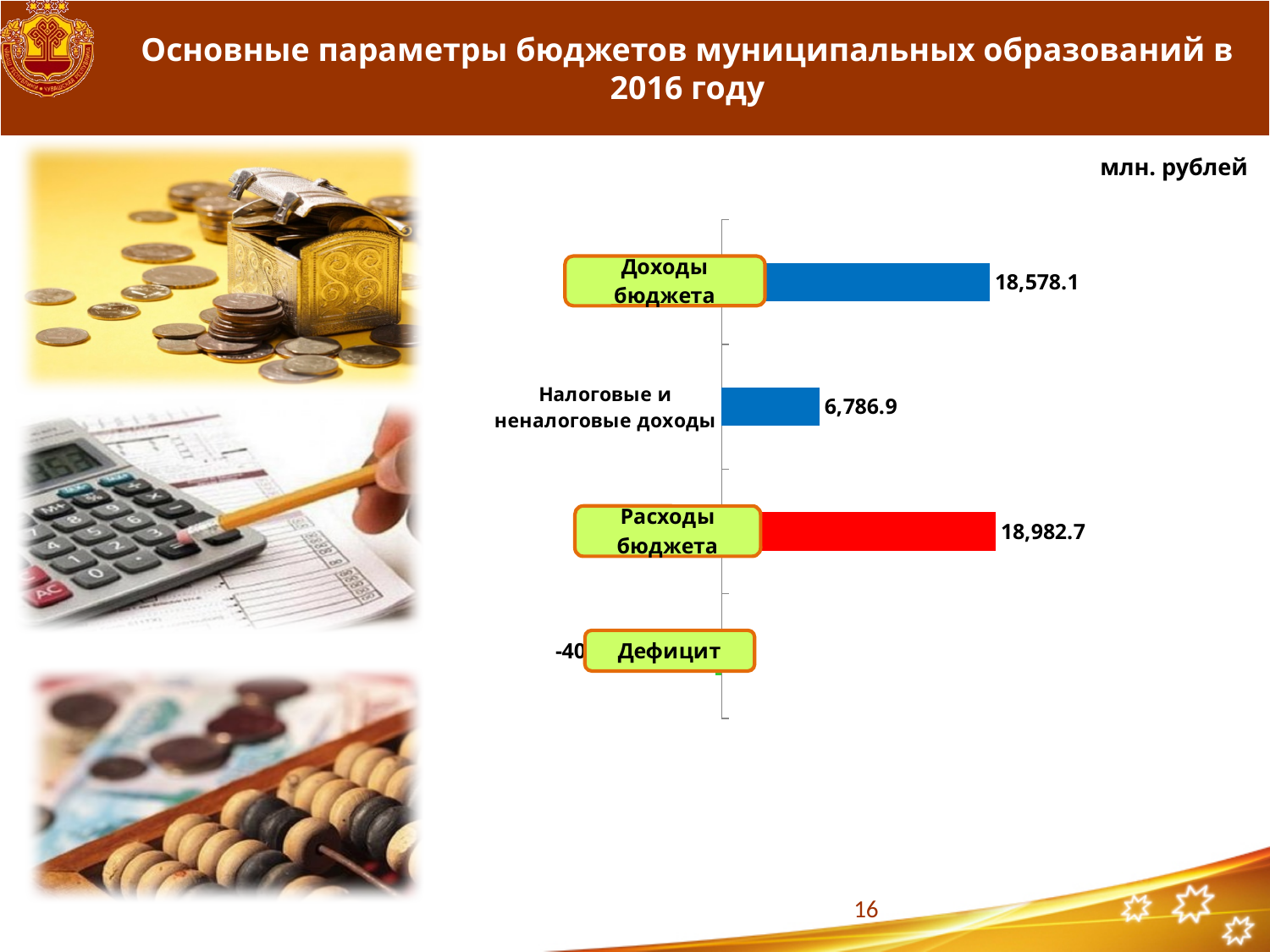
What is the value for Налоговые и неналоговые доходы? 6,786.9 What is the value for Доходы бюджета? 18,578.1 In what units are the chart values given? млн. рублей Which is larger, Доходы бюджета or Расходы бюджета? Расходы бюджета Which category has the highest value? Расходы бюджета What is the value for Расходы бюджета? 18,982.7 What colour is the bar for Расходы бюджета? Red What is the difference between Расходы бюджета and Доходы бюджета? 404.6 What is the difference between Доходы бюджета and Налоговые и неналоговые доходы? 11,791.2 Which is larger, Налоговые и неналоговые доходы or Доходы бюджета? Доходы бюджета How many categories are shown in the chart? 4 What kind of chart is shown on the slide? Bar chart